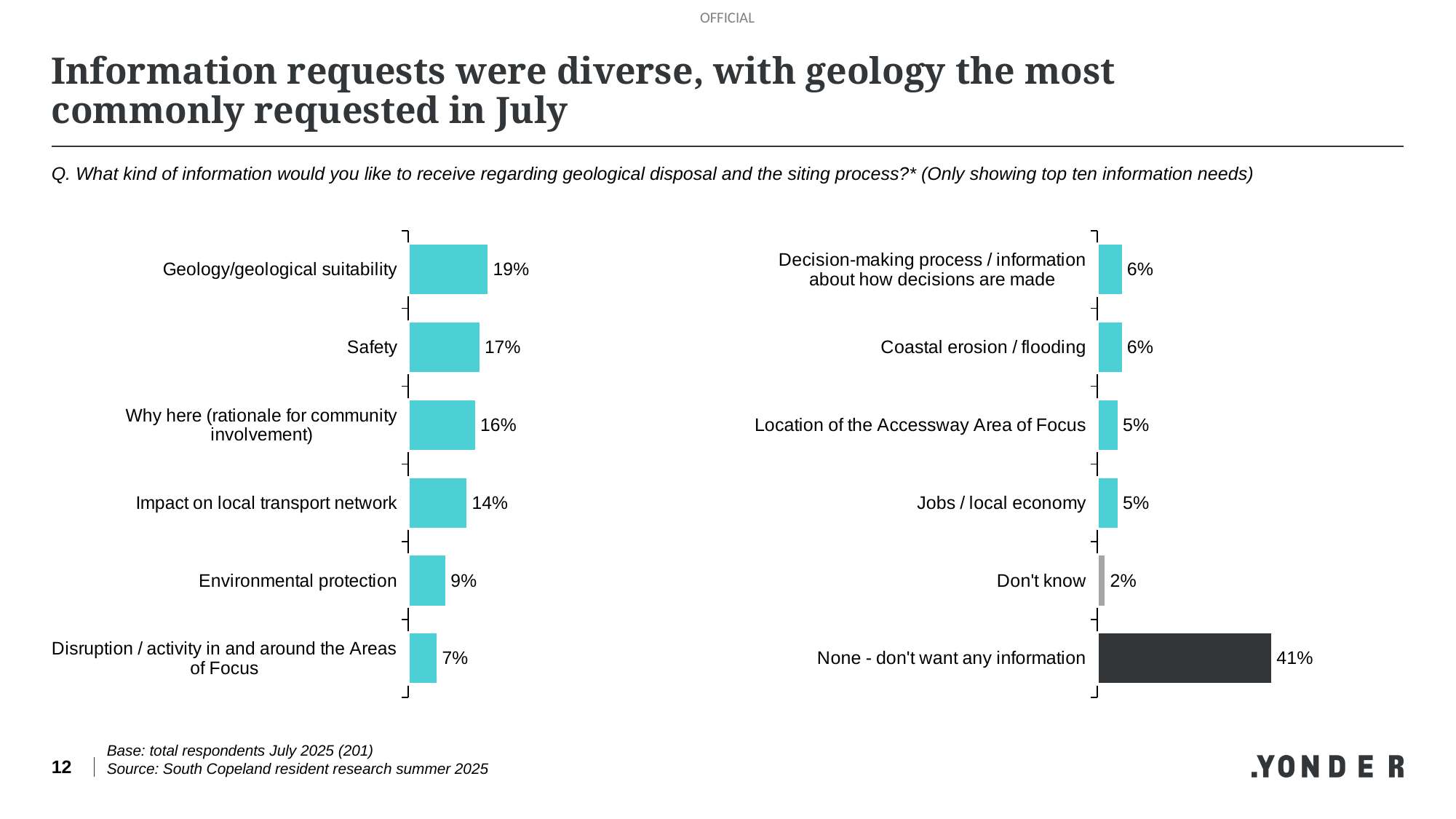
In the left chart, which category has the highest value? Geology/geological suitability In the right chart, what colour is the bar for None - don't want any information? Dark grey How many categories are shown in the left chart? 6 In the right chart, which category has the lowest value? Don't know In the left chart, what is the value for Geology/geological suitability? 19% What kind of chart is the right chart? Bar chart In the left chart, what is the difference between Safety and Environmental protection? 8% In the right chart, which is larger: Coastal erosion / flooding or Jobs / local economy? Coastal erosion / flooding In the left chart, which category has the lowest value? Disruption / activity in and around the Areas of Focus In the right chart, what is the value for None - don't want any information? 41% In the right chart, what is the value for Don't know? 2% In the left chart, what is the value for Impact on local transport network? 14%